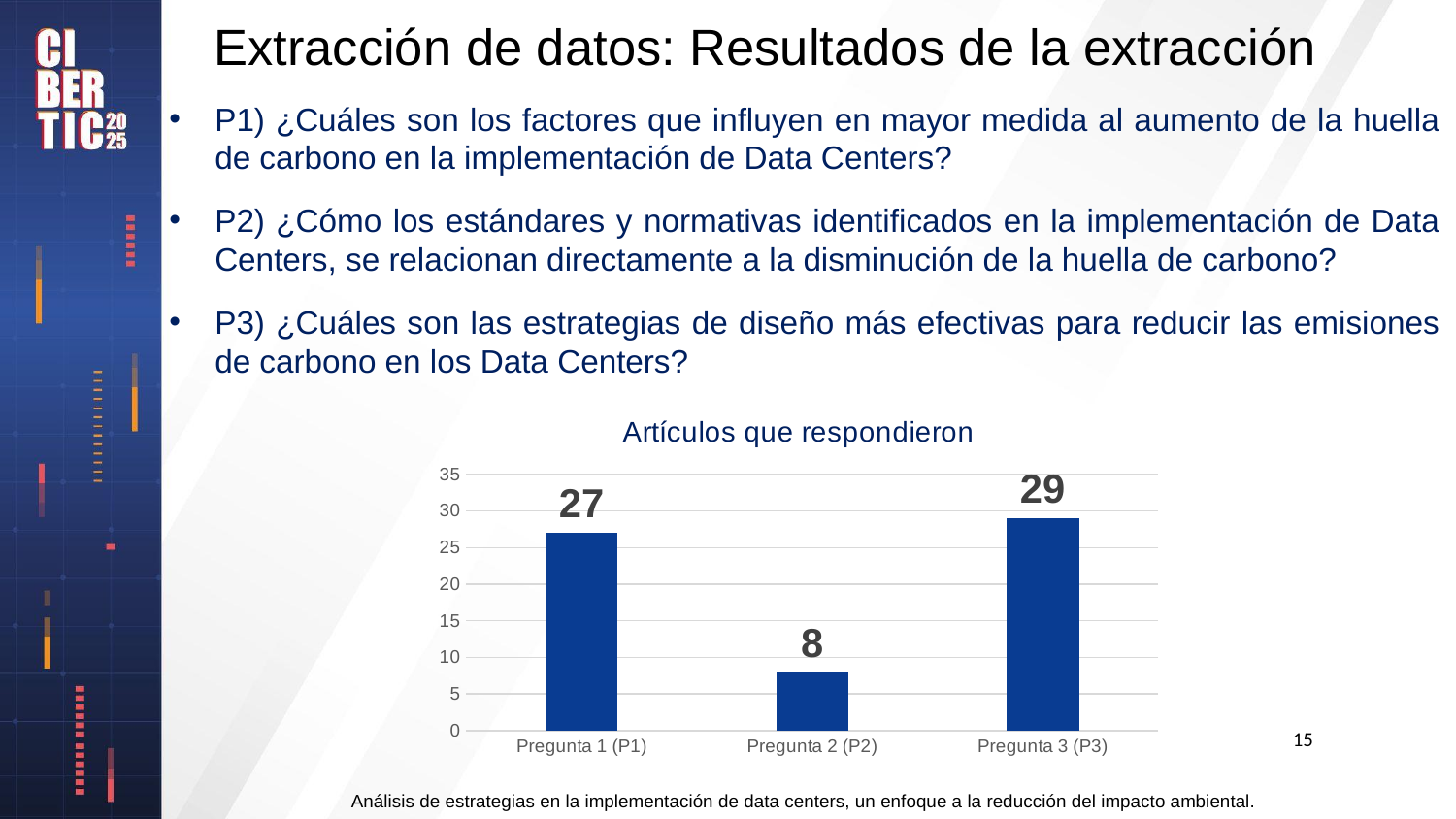
What is the difference between the values for Pregunta 3 (P3) and Pregunta 1 (P1)? 2 What is the difference between the values for Pregunta 1 (P1) and Pregunta 2 (P2)? 19 Which category has the highest value? Pregunta 3 (P3) What is the value for Pregunta 3 (P3)? 29 What is the title of the chart? Artículos que respondieron Which is larger, the value for Pregunta 1 (P1) or Pregunta 2 (P2)? Pregunta 1 (P1) What is the value for Pregunta 1 (P1)? 27 Which category has the lowest value? Pregunta 2 (P2) What kind of chart is shown on the slide? bar chart Is the value for Pregunta 2 (P2) greater or less than 10? less What is the value for Pregunta 2 (P2)? 8 How many categories are shown in the chart? 3